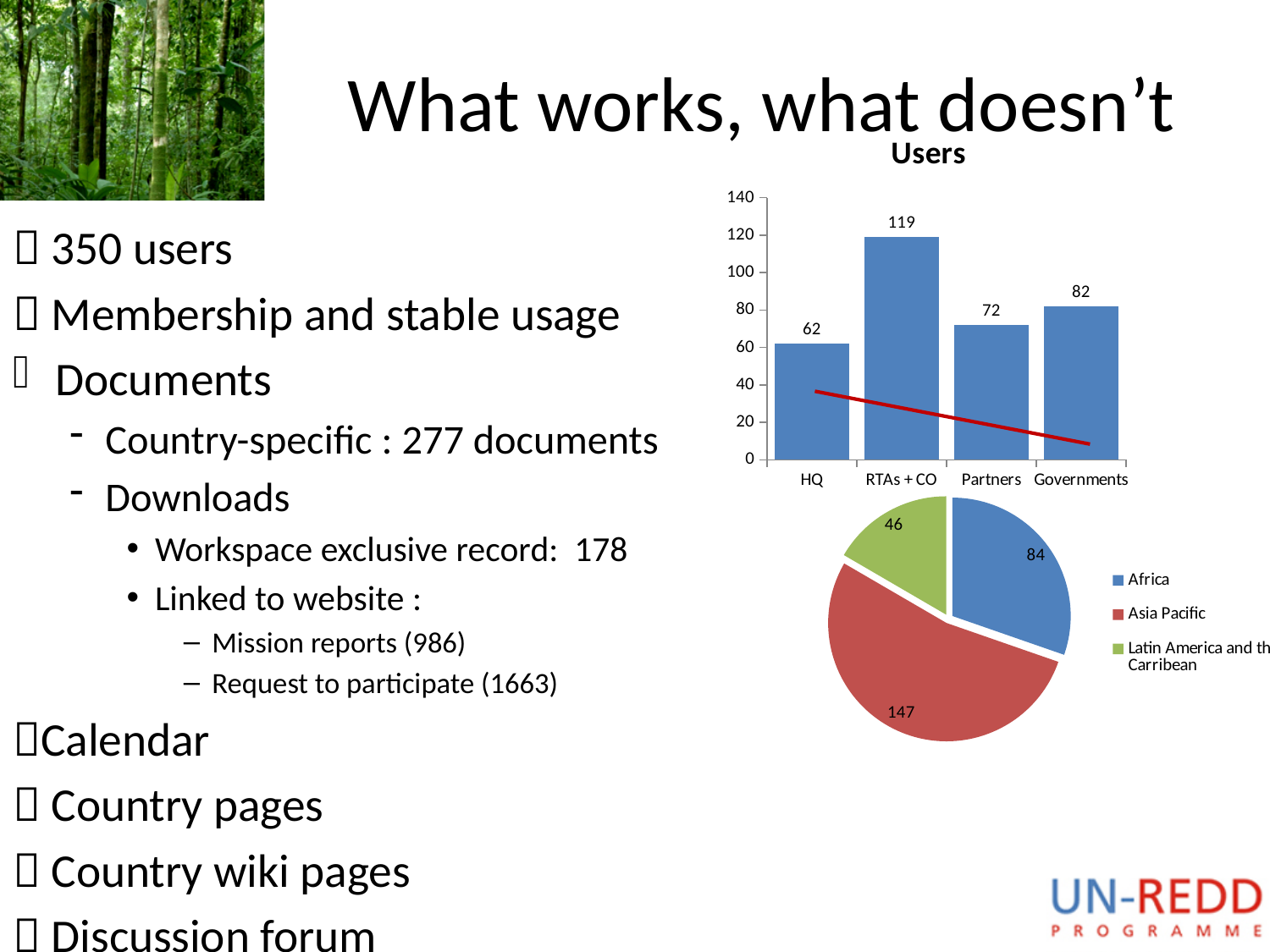
In the pie chart below the bar chart, which region has the smallest slice? Latin America and the Carribean In the bar chart titled "Users", which category has the highest value? RTAs + CO In the bar chart titled "Users", what is the difference between the values for Governments and Partners? 10 In the pie chart below the bar chart, what is the value for Asia Pacific? 147 In the bar chart titled "Users", what is the value for RTAs + CO? 119 In the bar chart titled "Users", how many categories are shown on the x axis? 4 How many entries does the legend of the pie chart list? 3 What kind of chart is the chart titled "Users"? bar chart In the bar chart titled "Users", which category has the lowest value? HQ In the bar chart titled "Users", which is larger, the value for Partners or the value for Governments? Governments In the pie chart below the bar chart, what is the difference between the values for Asia Pacific and Africa? 63 In the bar chart titled "Users", what is the value for HQ? 62